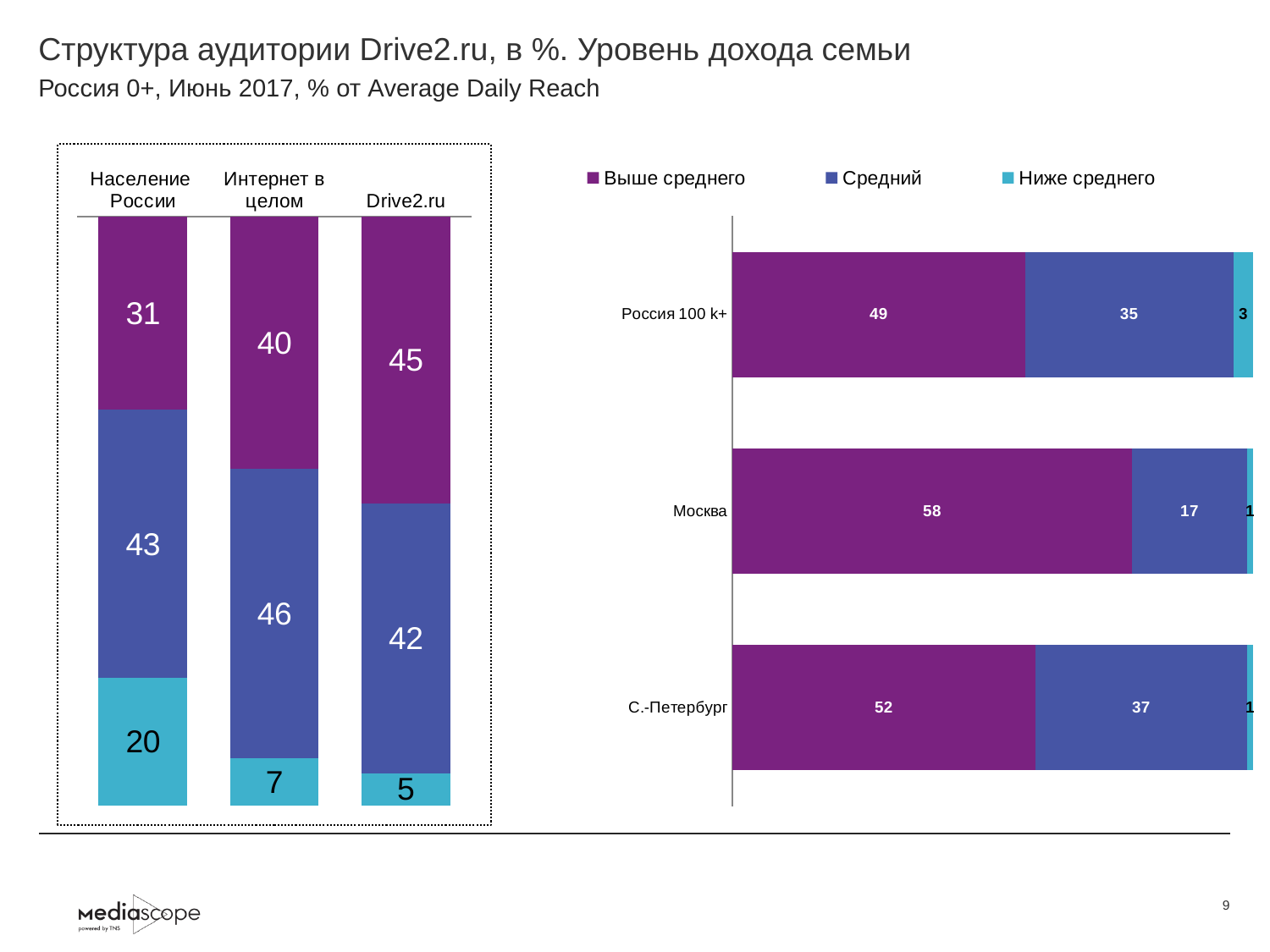
In the left chart, what is the value of the 'Выше среднего' segment for Drive2.ru? 45 In the left chart, how many categories are shown? 3 In the right chart, which category has the highest 'Выше среднего' value? Москва How many series does the legend of the right chart list? 3 In the left chart, what is the value of the bottom (Ниже среднего) segment for Население России? 20 In the right chart, what is the 'Ниже среднего' value for Россия 100 k+? 3 In the right chart, what is the 'Средний' value for С.-Петербург? 37 In the left chart, what is the value of the middle (Средний) segment for Интернет в целом? 46 In the left chart, which is larger: the 'Средний' value for Население России or for Drive2.ru? Население России In the left chart, which category has the lowest 'Ниже среднего' value? Drive2.ru In the left chart, what is the difference between the 'Выше среднего' values for Drive2.ru and Население России? 14 In the right chart, what is the 'Выше среднего' value for Москва? 58